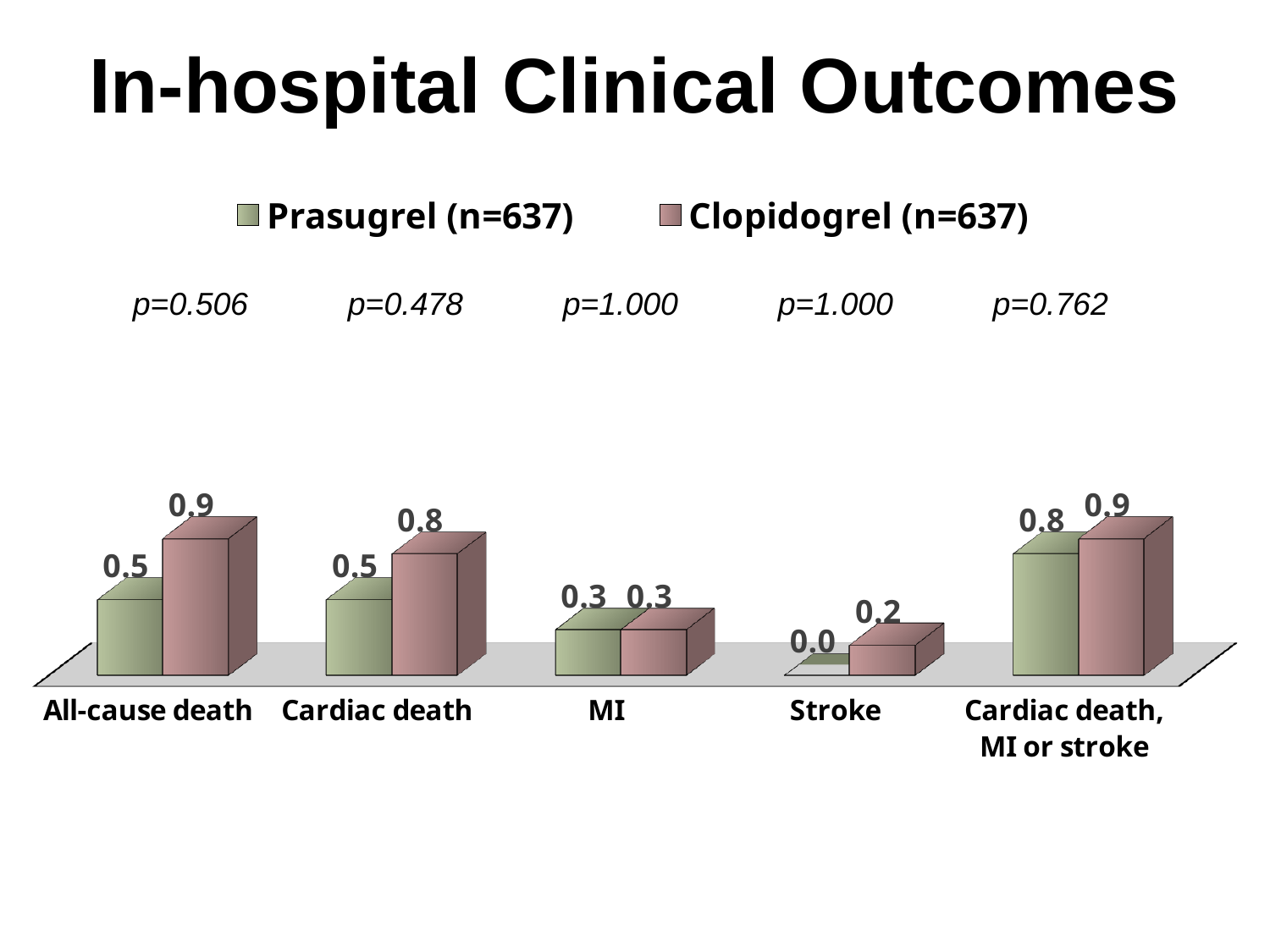
What kind of chart is shown on the slide? Bar chart What is the value for Prasugrel (n=637) for All-cause death? 0.5 Which category has the lowest value for Prasugrel (n=637)? Stroke What is the value for Clopidogrel (n=637) for Cardiac death? 0.8 What is the value for Clopidogrel (n=637) for Stroke? 0.2 What is the difference between the Clopidogrel (n=637) and Prasugrel (n=637) values for All-cause death? 0.4 How many categories are shown on the x axis? 5 What is the value for Prasugrel (n=637) for Cardiac death, MI or stroke? 0.8 How many series does the legend list? 2 What p-value is shown above the MI category? p=1.000 Which is larger for Cardiac death: the Prasugrel (n=637) value or the Clopidogrel (n=637) value? Clopidogrel (n=637) Which category has the highest value for Clopidogrel (n=637)? All-cause death and Cardiac death, MI or stroke (both 0.9)